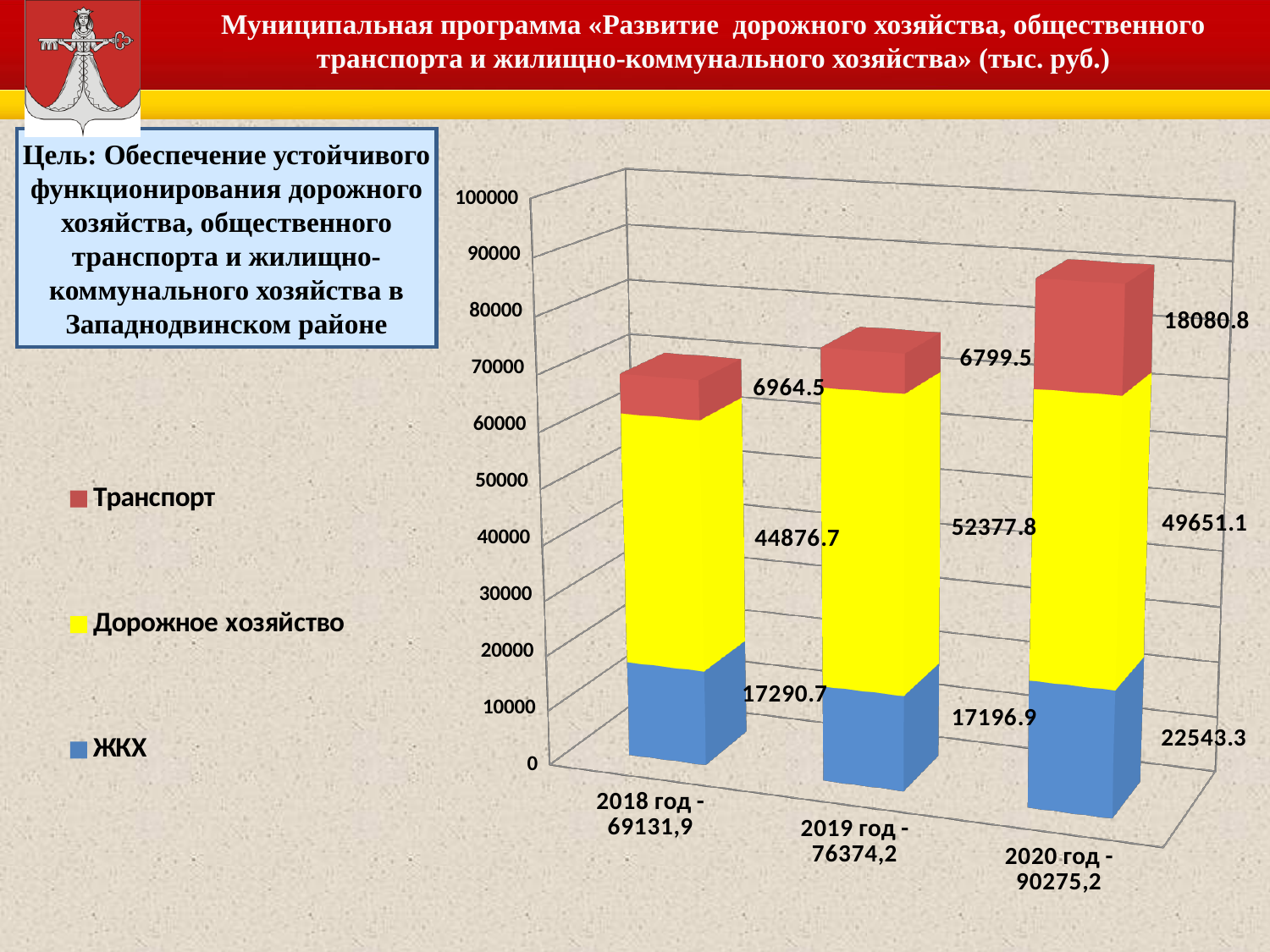
Which is larger: the ЖКХ value for 2018 год or for 2019 год? 2018 год What is the value for Дорожное хозяйство in 2019 год? 52377.8 What is the value for Транспорт in 2018 год? 6964.5 What is the value for ЖКХ in 2020 год? 22543.3 What kind of chart is shown on the slide? Stacked bar chart How many series does the legend list? 3 How many years (categories) are shown on the x axis? 3 Do the bar totals rise or fall from 2018 год to 2020 год? Rise What is the total of the stacked bar for 2020 год? 90275,2 What is the difference between the Транспорт values for 2020 год and 2019 год? 11281.3 In which year is the Транспорт value lowest? 2019 год In which year is the Дорожное хозяйство value highest? 2019 год